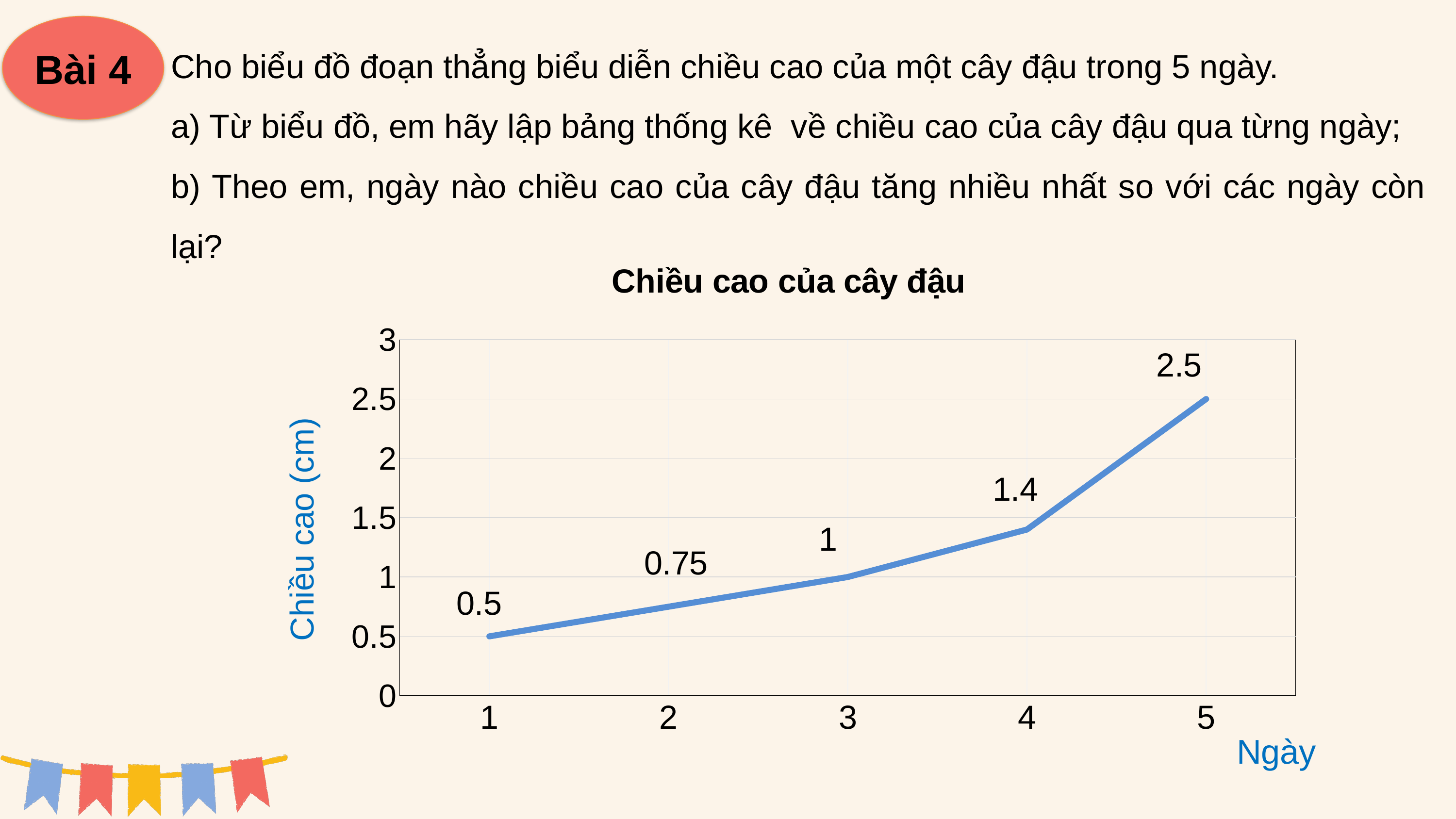
What is the difference in height between day 3 and day 1? 0.5 What is the height of the bean plant on day 4? 1.4 Which day has a greater height, day 3 or day 4? 4 On which day is the plant height the lowest? 1 On which day is the plant height the highest? 5 What is the difference in height between day 5 and day 4? 1.1 What is the height of the bean plant on day 5? 2.5 Does the plant height rise or fall from day 1 to day 5? rise What is the height of the bean plant on day 2? 0.75 How many days are plotted on the chart? 5 What is the height of the bean plant on day 1? 0.5 What kind of chart is shown on the slide? line chart